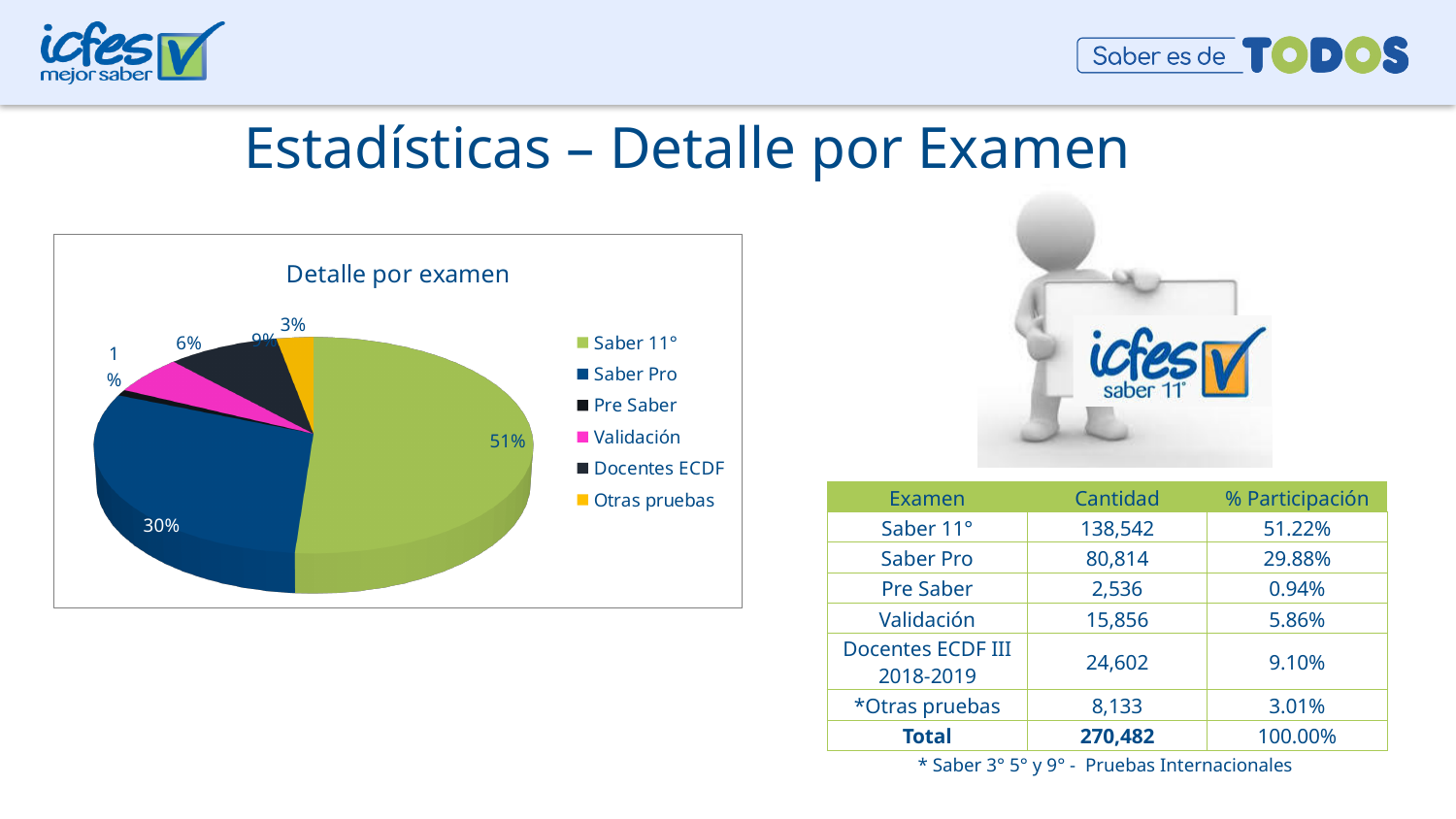
Which category has the smallest slice of the pie? Pre Saber What kind of chart is shown on the slide? pie chart What share of the pie does Saber 11° represent? 51% How many entries does the chart legend list? 6 Which category has the largest slice of the pie? Saber 11° What share of the pie does Saber Pro represent? 30% What is the difference in percentage points between the Saber 11° slice and the Saber Pro slice? 21% What share of the pie does Otras pruebas represent? 3% What is the title of the chart? Detalle por examen How many slices does the pie chart have? 6 What share of the pie does Validación represent? 6% Which slice is larger, Saber Pro or Validación? Saber Pro